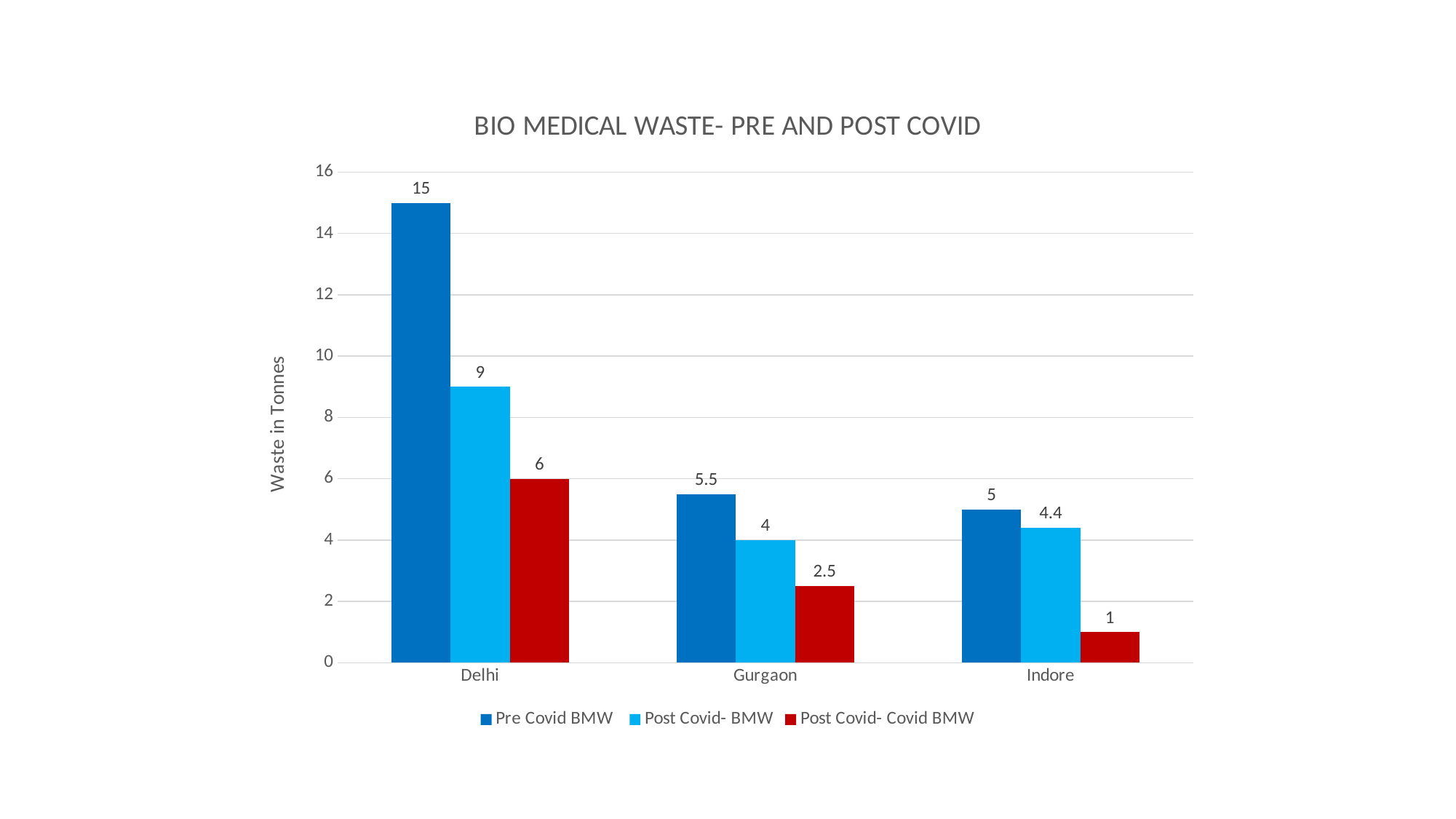
How many series does the legend list? 3 Which city has the highest Pre Covid BMW value? Delhi What is the difference between the Pre Covid BMW and Post Covid- BMW values for Delhi? 6 Which city has the lowest Post Covid- Covid BMW value? Indore Is the Pre Covid BMW value for Gurgaon greater or less than 4? greater What kind of chart is shown on the slide? Bar chart Which is larger: the Post Covid- BMW value for Gurgaon or the Post Covid- BMW value for Indore? Indore What is the title of the chart? BIO MEDICAL WASTE- PRE AND POST COVID What is the Post Covid- BMW value for Indore? 4.4 How many cities are shown on the x axis? 3 What is the Pre Covid BMW value for Delhi? 15 What is the Post Covid- Covid BMW value for Gurgaon? 2.5